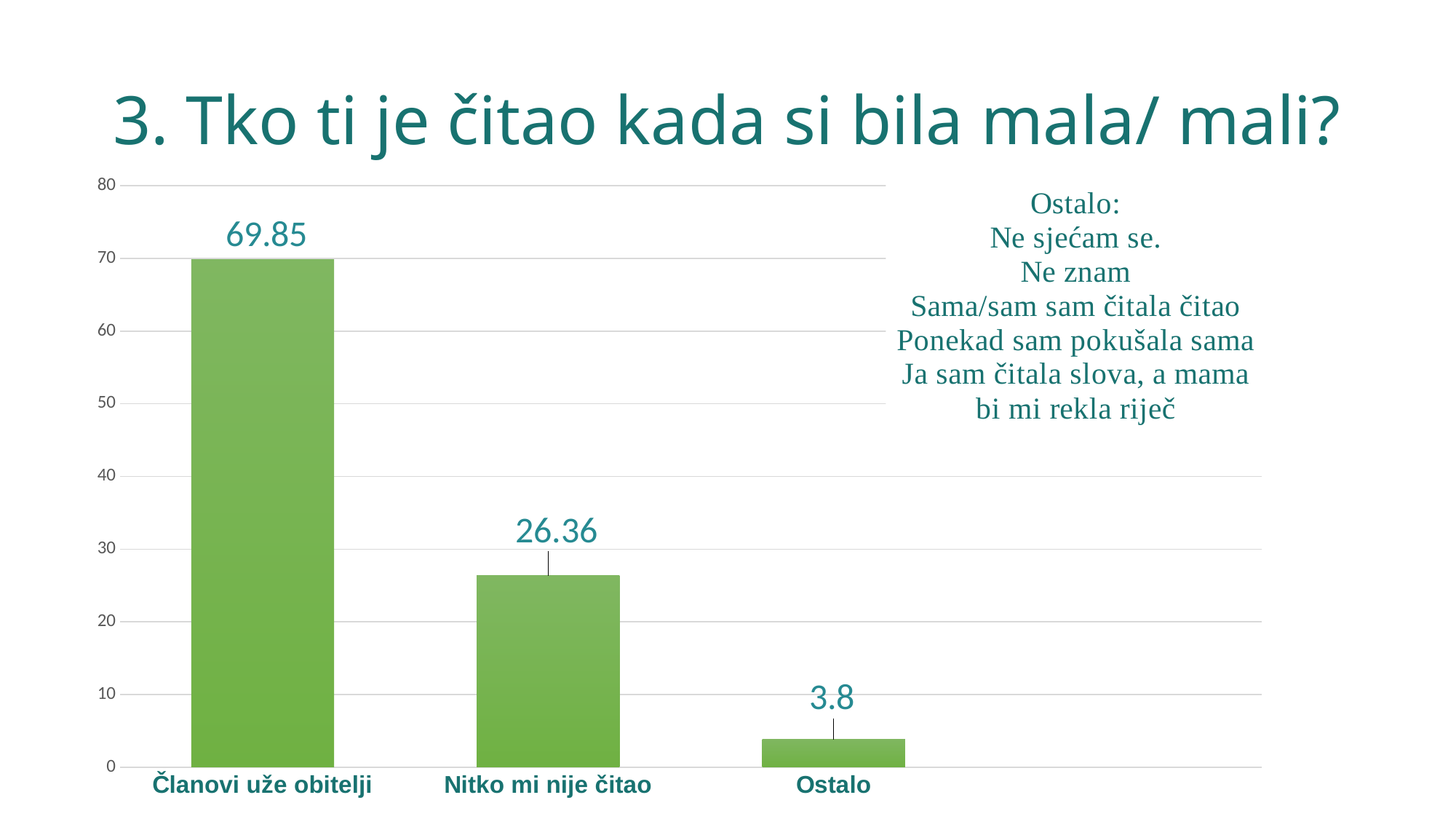
What kind of chart is shown on the slide? bar chart Which is larger, the value for Nitko mi nije čitao or the value for Ostalo? Nitko mi nije čitao What is the difference between the values for Nitko mi nije čitao and Ostalo? 22.56 What is the difference between the values for Članovi uže obitelji and Nitko mi nije čitao? 43.49 Do the values rise or fall from left to right across the categories? fall How many categories are shown on the chart? 3 Which category has the lowest value? Ostalo Is the value for Nitko mi nije čitao greater or less than 30? less What is the value for Nitko mi nije čitao? 26.36 What is the value for Članovi uže obitelji? 69.85 Which category has the highest value? Članovi uže obitelji What is the value for Ostalo? 3.8